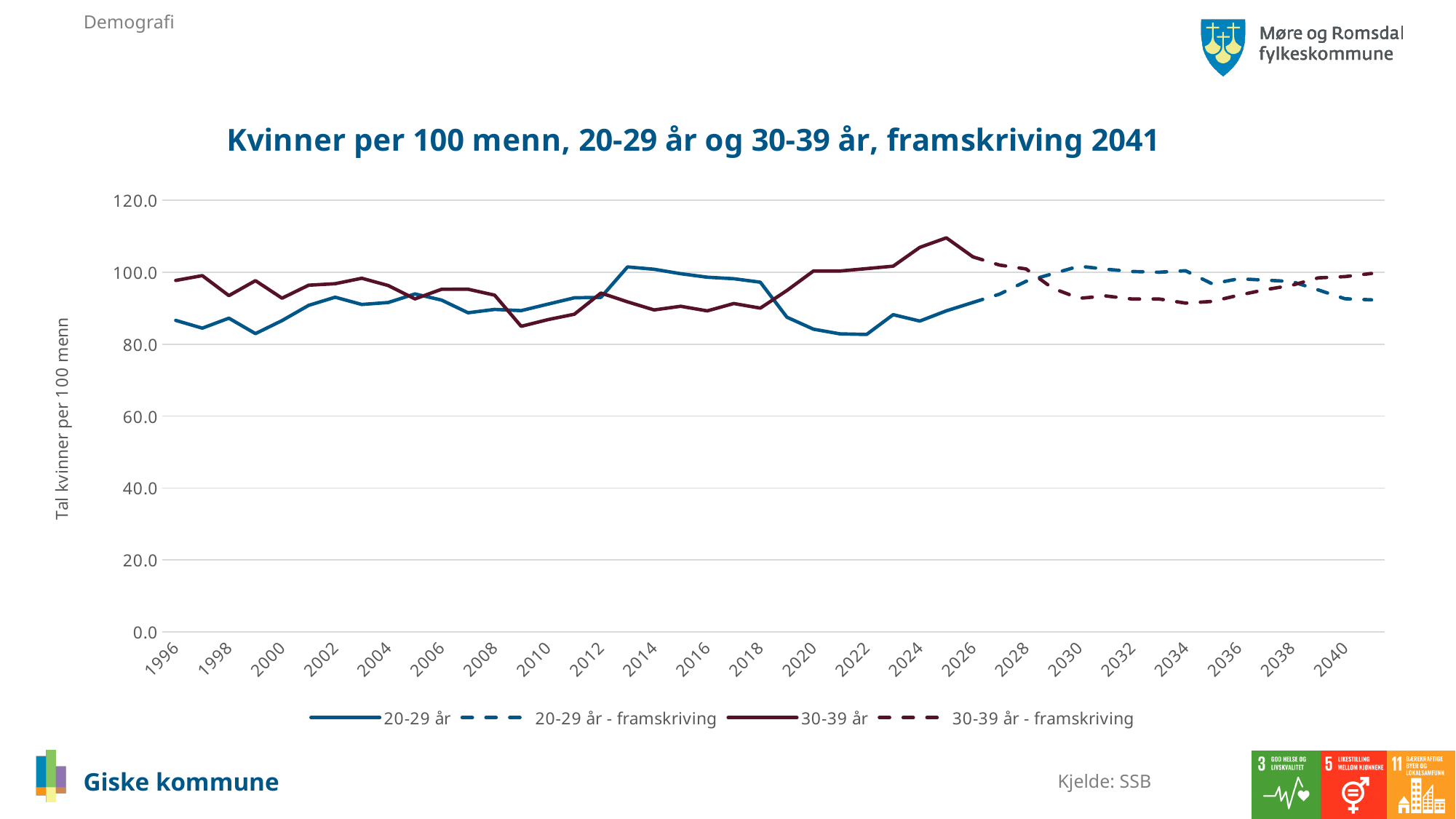
Is the value for 30-39 år in 2025 greater or less than 100? greater What is the label on the vertical axis? Tal kvinner per 100 menn Is the value for 20-29 år in 1999 greater or less than 100? less Is the value for 30-39 år in 2009 greater or less than 100? less Does the 30-39 år line rise or fall between 2019 and 2025? rise Does the 20-29 år line rise or fall between 2019 and 2022? fall What kind of chart is shown on the slide? line chart How many series does the legend list? 4 What is the title of the chart? Kvinner per 100 menn, 20-29 år og 30-39 år, framskriving 2041 In 2014, which series has the higher value, 20-29 år or 30-39 år? 20-29 år In 2022, which series has the higher value, 20-29 år or 30-39 år? 30-39 år